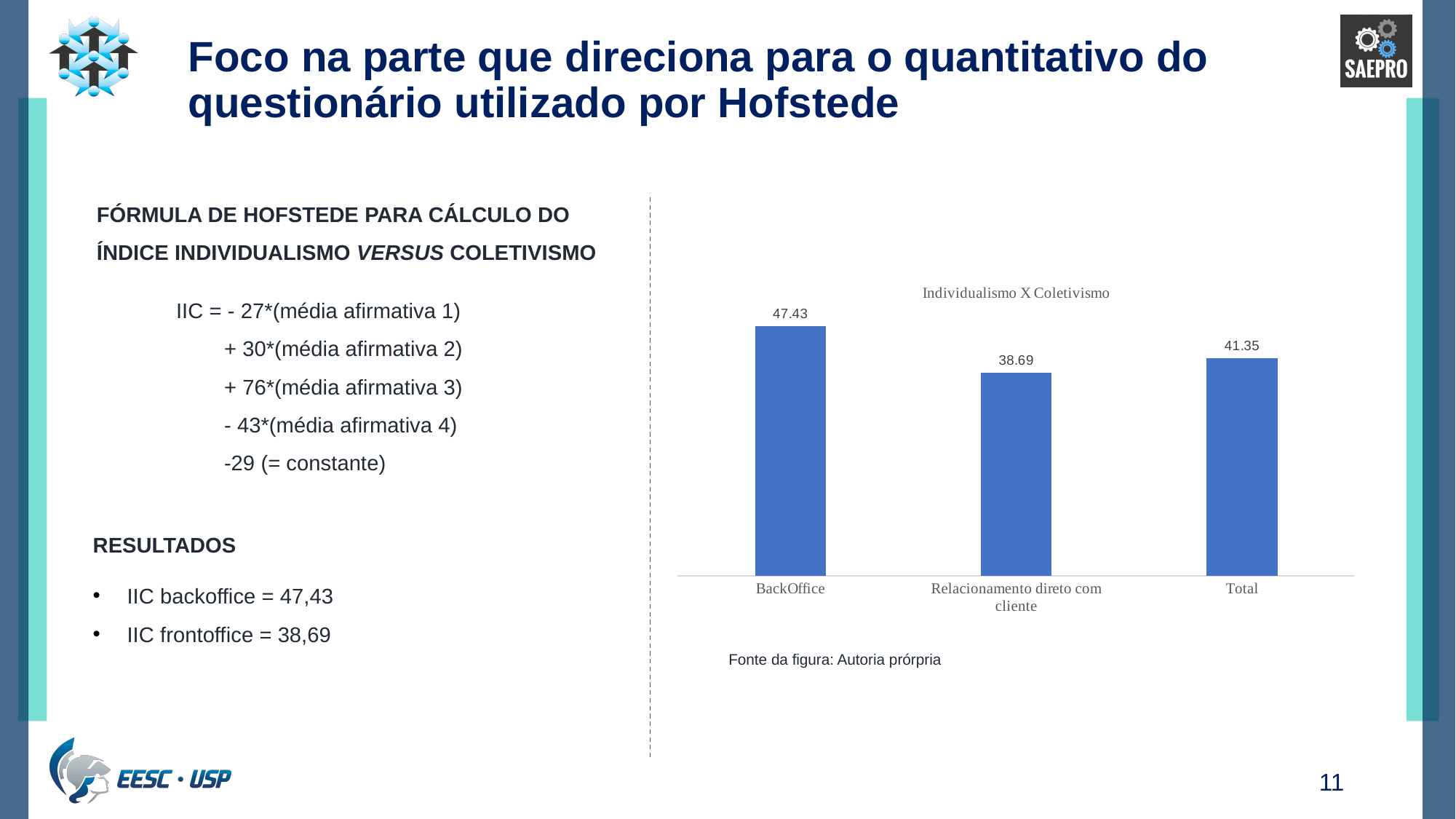
What is the value for BackOffice? 47.43 What kind of chart is shown on the slide? Bar chart How many categories are shown in the chart? 3 What is the title of the chart? Individualismo X Coletivismo What is the value for Relacionamento direto com cliente? 38.69 What is the difference between the values for BackOffice and Total? 6.08 Which is larger, the value for Total or the value for Relacionamento direto com cliente? Total What is the value for Total? 41.35 Which category has the highest value? BackOffice What colour are the bars in the chart? Blue What is the difference between the values for BackOffice and Relacionamento direto com cliente? 8.74 Which category has the lowest value? Relacionamento direto com cliente